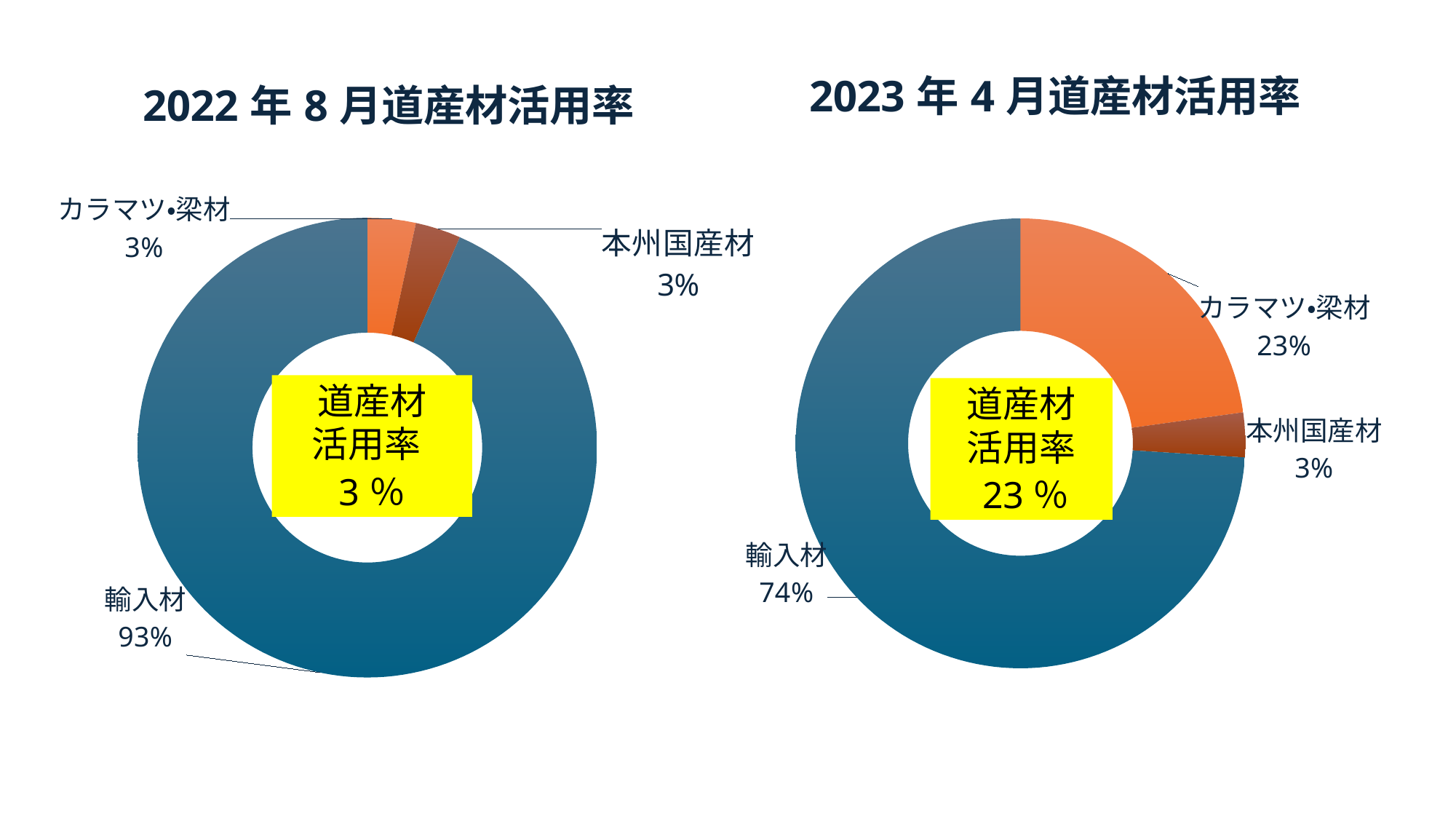
What 道産材活用率 value is shown in the centre of the right chart (2023年4月道産材活用率)? 23 % In the left chart (2022年8月道産材活用率), what is the value for カラマツ•梁材? 3% In the right chart (2023年4月道産材活用率), what is the value for 輸入材? 74% In the right chart (2023年4月道産材活用率), which is larger, カラマツ•梁材 or 本州国産材? カラマツ•梁材 In the left chart (2022年8月道産材活用率), what is the value for 輸入材? 93% In the right chart (2023年4月道産材活用率), which category has the smallest share? 本州国産材 In the right chart (2023年4月道産材活用率), what is the difference between 輸入材 and カラマツ•梁材? 51% What kind of chart is the right chart (2023年4月道産材活用率)? Doughnut (pie) chart In the left chart (2022年8月道産材活用率), which category has the largest share? 輸入材 In the right chart (2023年4月道産材活用率), what is the value for カラマツ•梁材? 23% In the right chart (2023年4月道産材活用率), what is the value for 本州国産材? 3% How many categories does the left chart (2022年8月道産材活用率) show? 3